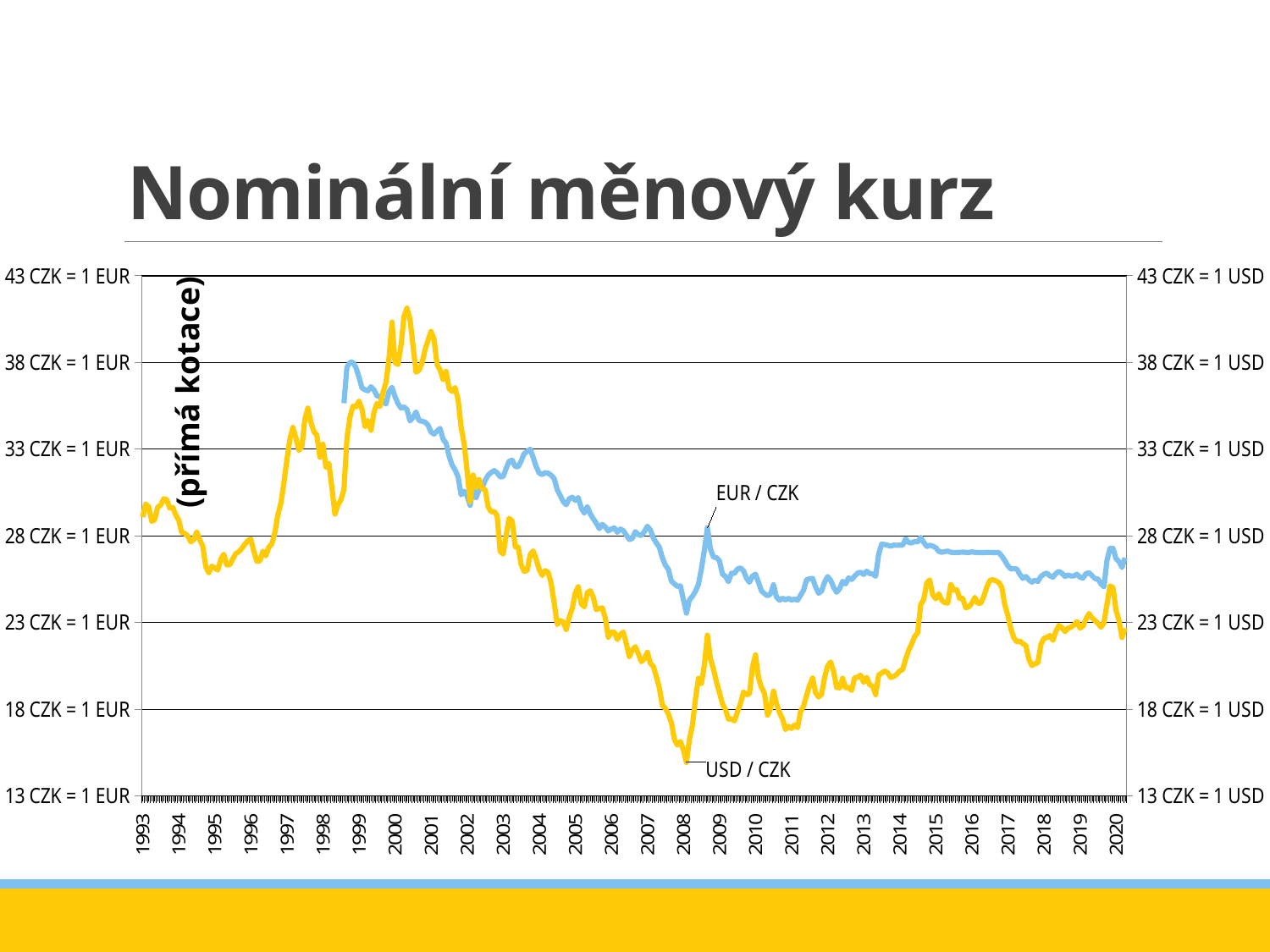
What is the title of the slide above the chart? Nominální měnový kurz How many series are plotted on the chart? 2 Is the value of the USD / CZK series in 2020 greater or less than 28? less Which series is drawn in yellow? USD / CZK Is the peak value of the USD / CZK series around 2000 greater or less than 38? greater Does the USD / CZK series rise or fall between 1996 and 2000? rise In 2015, which series has the higher value, EUR / CZK or USD / CZK? EUR / CZK Is the value of the EUR / CZK series in 2020 greater or less than 23? greater What kind of chart is shown on the slide? line chart Does the EUR / CZK series rise or fall between 2000 and 2008? fall In 2000, which series has the higher value, EUR / CZK or USD / CZK? USD / CZK